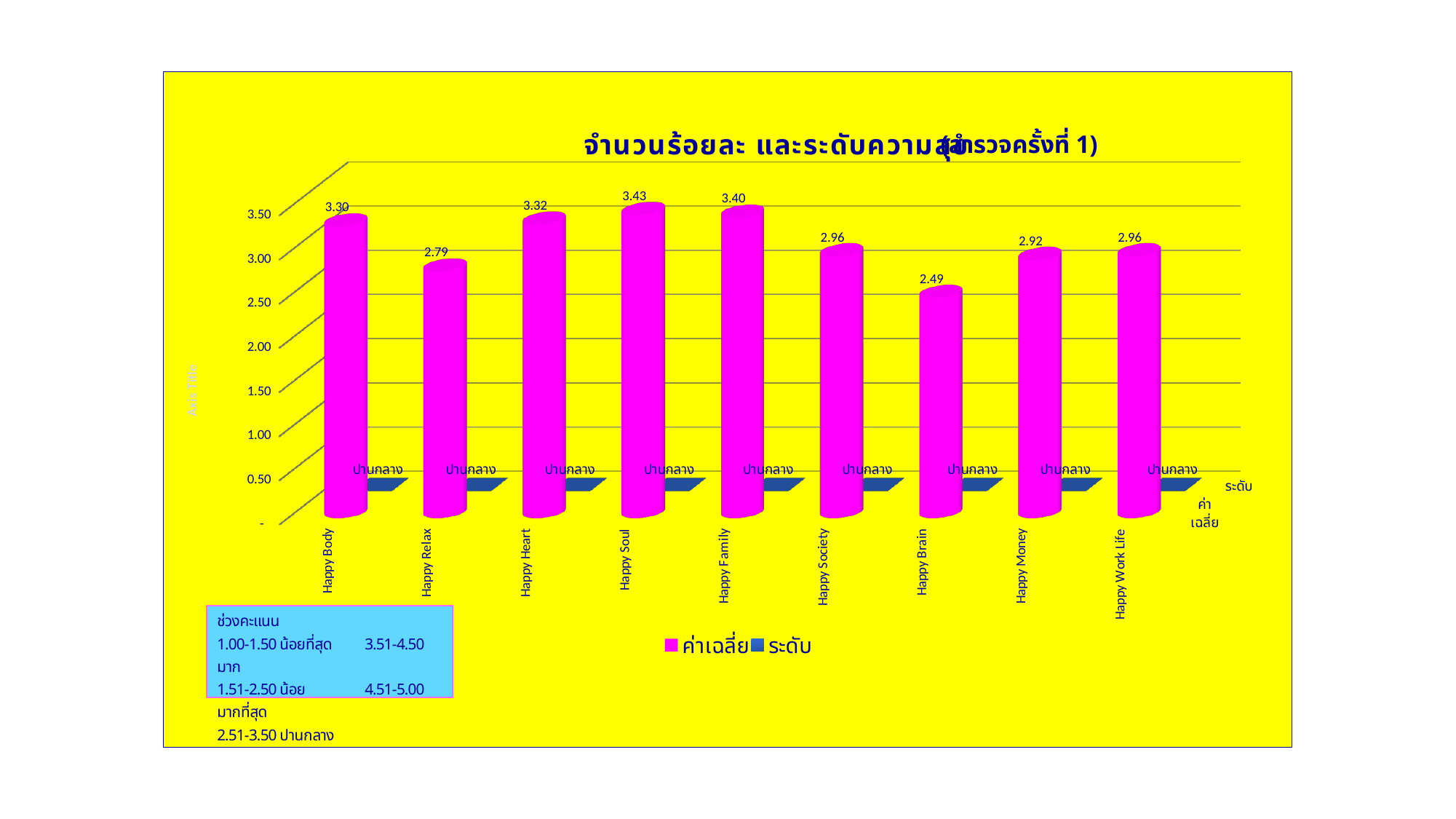
How many categories are shown on the x axis? 9 What kind of chart is shown? bar chart What is the value for Happy Brain? 2.49 What level label (ระดับ) is shown for every category? ปานกลาง Which is larger, the value for Happy Body or the value for Happy Money? Happy Body What is the value for Happy Soul? 3.43 Which category has the highest value? Happy Soul Which category has the lowest value? Happy Brain What is the difference between the values for Happy Soul and Happy Brain? 0.94 What is the value for Happy Relax? 2.79 Is the value for Happy Family greater or less than 3.00? greater How many series does the legend list? 2